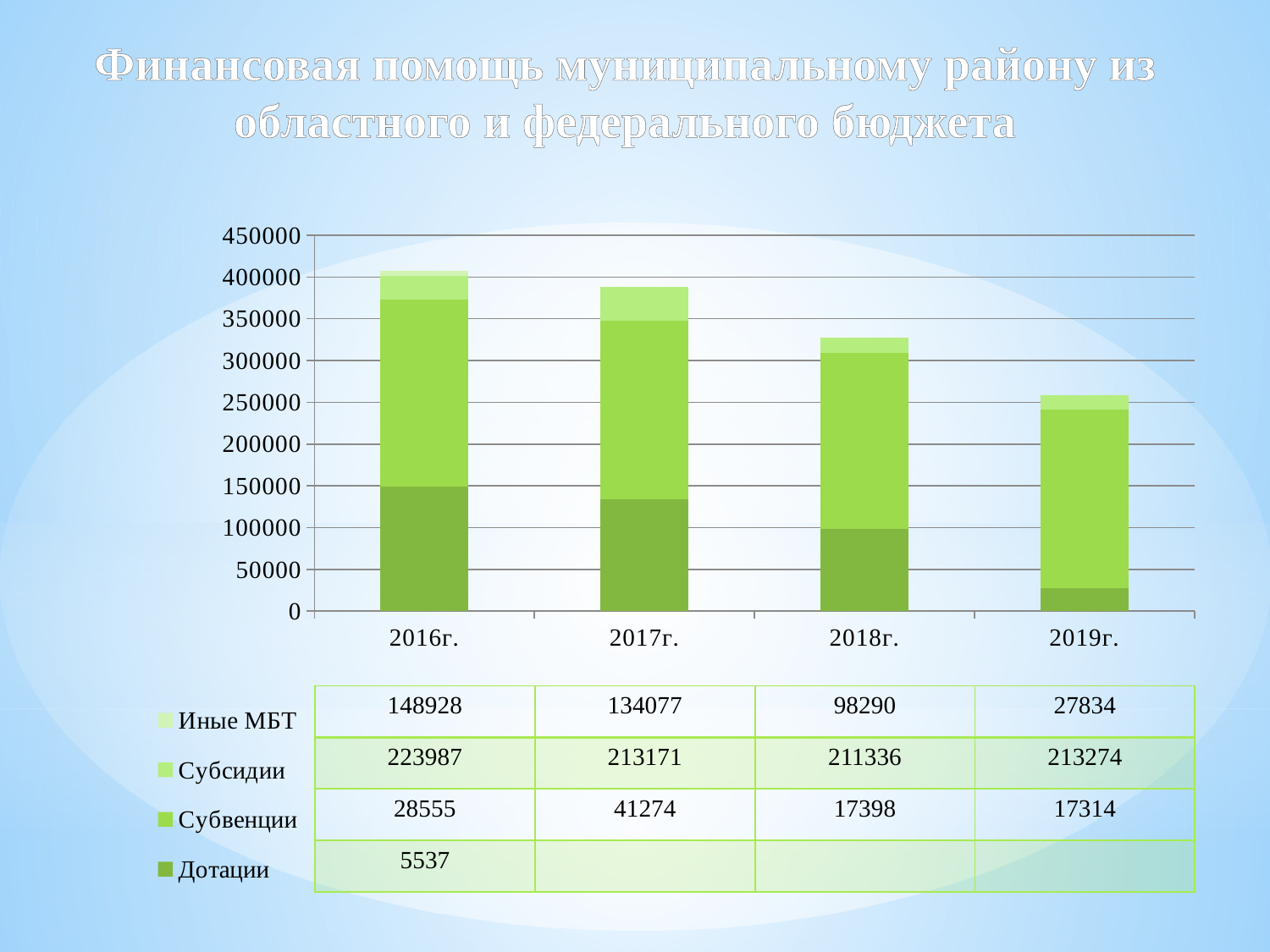
What is the title of the chart slide? Финансовая помощь муниципальному району из областного и федерального бюджета Do the total bar heights rise or fall from 2016г. to 2019г.? fall What is the total of the stacked bar for 2019г., using the values in the data table? 258422 What is the total of the stacked bar for 2016г., using the values in the data table? 407007 How many years (categories) are shown on the x axis of the chart? 4 Is the total for 2018г. greater or less than 300000? greater Is the total for 2019г. greater or less than 300000? less What kind of chart is shown on the slide? stacked bar chart How many series does the chart legend list? 4 Which year has the shortest stacked bar? 2019г. Which year has the tallest stacked bar? 2016г.